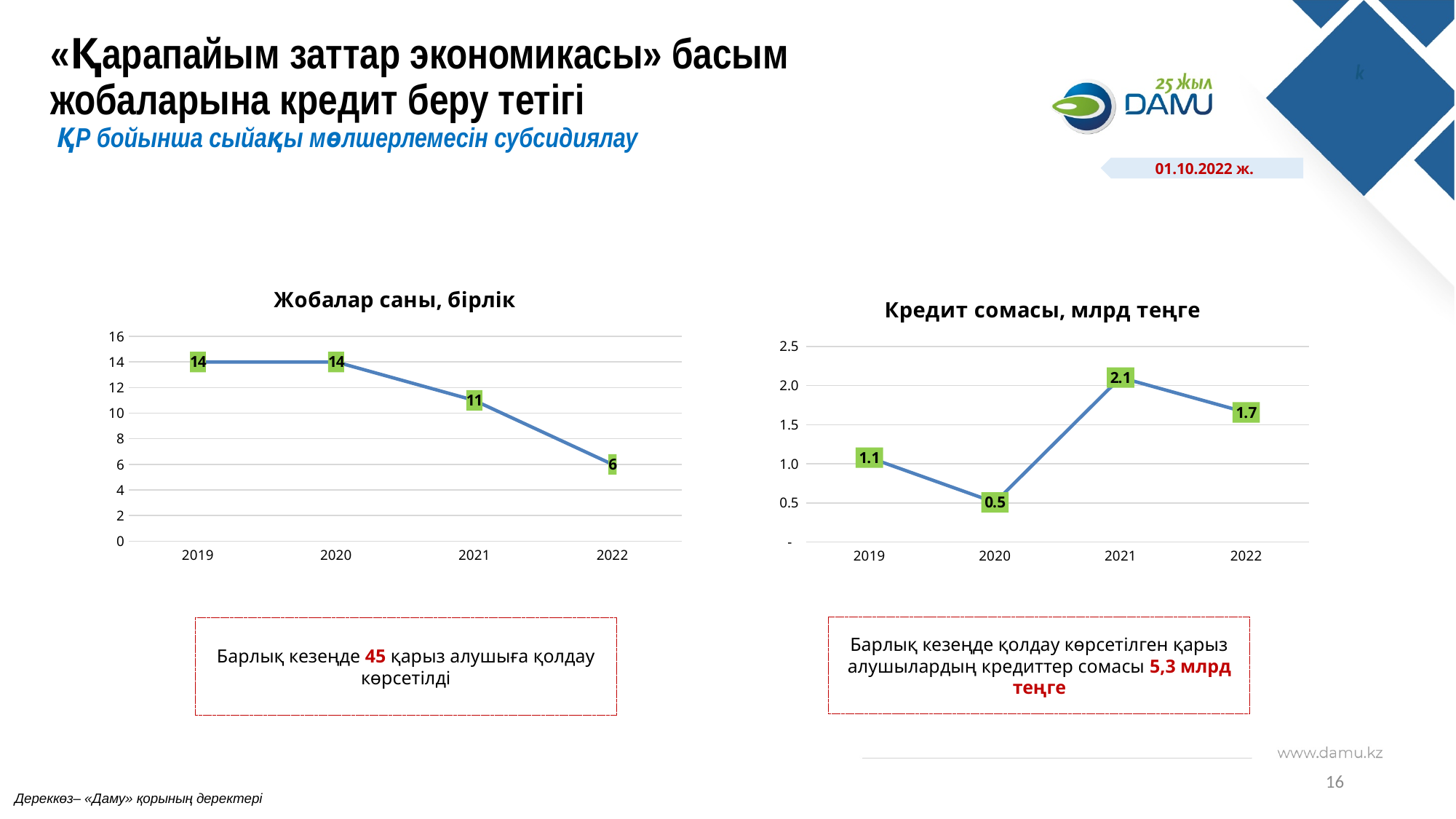
In the 'Кредит сомасы, млрд теңге' chart, what is the value for 2022? 1.7 In the 'Кредит сомасы, млрд теңге' chart, what is the value for 2020? 0.5 What kind of chart is the 'Кредит сомасы, млрд теңге' chart? line chart In the 'Жобалар саны, бірлік' chart, which year has the lowest value? 2022 In the 'Кредит сомасы, млрд теңге' chart, which year has the highest value? 2021 In the 'Жобалар саны, бірлік' chart, what is the value for 2021? 11 In the 'Жобалар саны, бірлік' chart, what is the difference between the values for 2020 and 2022? 8 In the 'Кредит сомасы, млрд теңге' chart, which is larger, the value for 2019 or the value for 2022? 2022 In the 'Жобалар саны, бірлік' chart, what is the value for 2022? 6 In the 'Жобалар саны, бірлік' chart, how many years are plotted? 4 In the 'Кредит сомасы, млрд теңге' chart, what is the difference between the values for 2021 and 2020? 1.6 In the 'Жобалар саны, бірлік' chart, do the values rise or fall from 2020 to 2022? fall